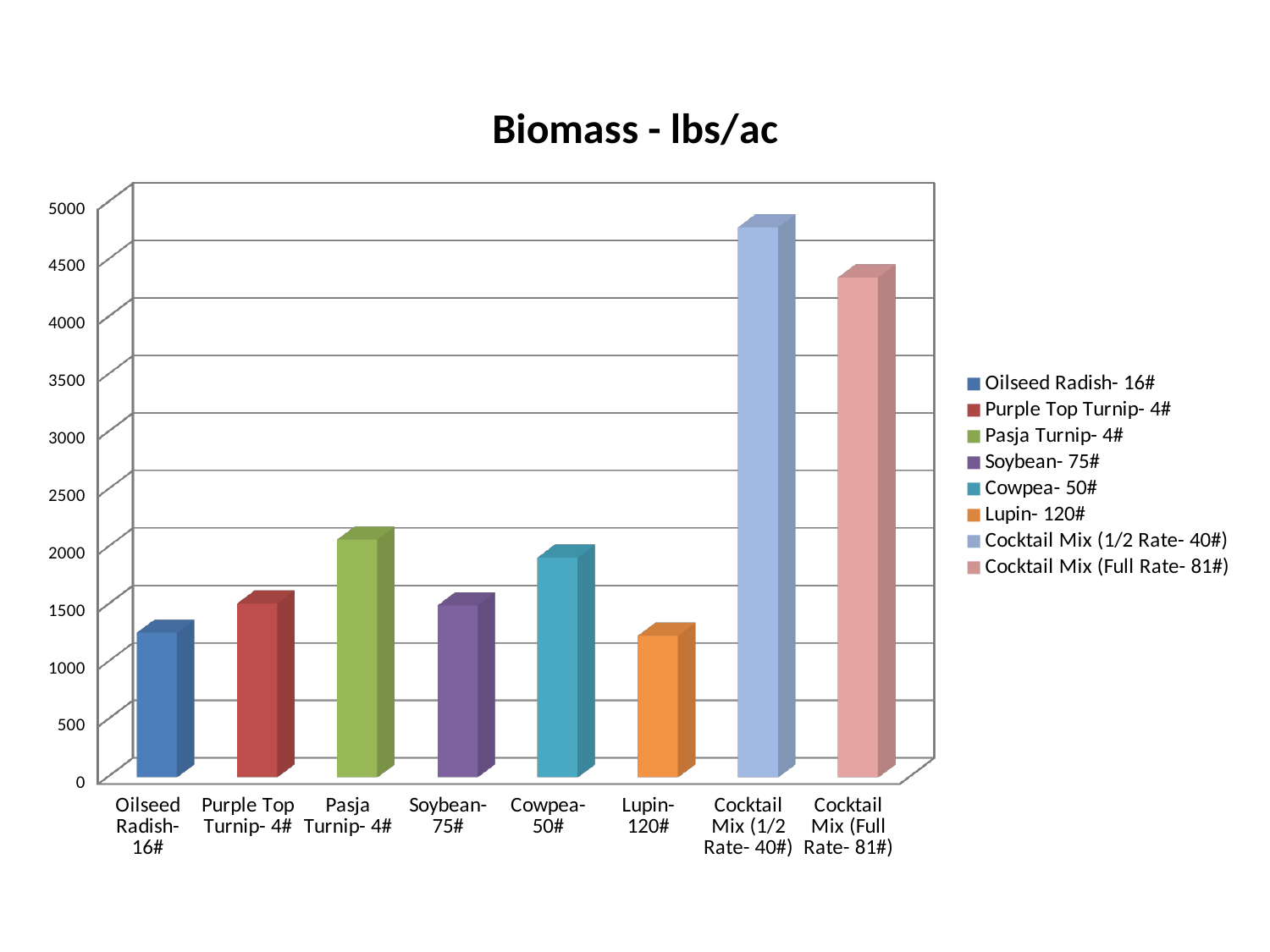
Is the value for Lupin- 120# greater or less than 1500? less Is the value for Pasja Turnip- 4# greater or less than 1500? greater What is the title of the chart? Biomass - lbs/ac Is the value for Cocktail Mix (Full Rate- 81#) greater or less than 4500? less Which category has the highest biomass? Cocktail Mix (1/2 Rate- 40#) Which has the larger biomass, Pasja Turnip- 4# or Soybean- 75#? Pasja Turnip- 4# How many entries does the legend list? 8 How many categories (bars) are plotted in the chart? 8 Which has the larger biomass, Cocktail Mix (1/2 Rate- 40#) or Cocktail Mix (Full Rate- 81#)? Cocktail Mix (1/2 Rate- 40#) Which has the larger biomass, Cowpea- 50# or Lupin- 120#? Cowpea- 50# What kind of chart is shown on the slide? bar chart